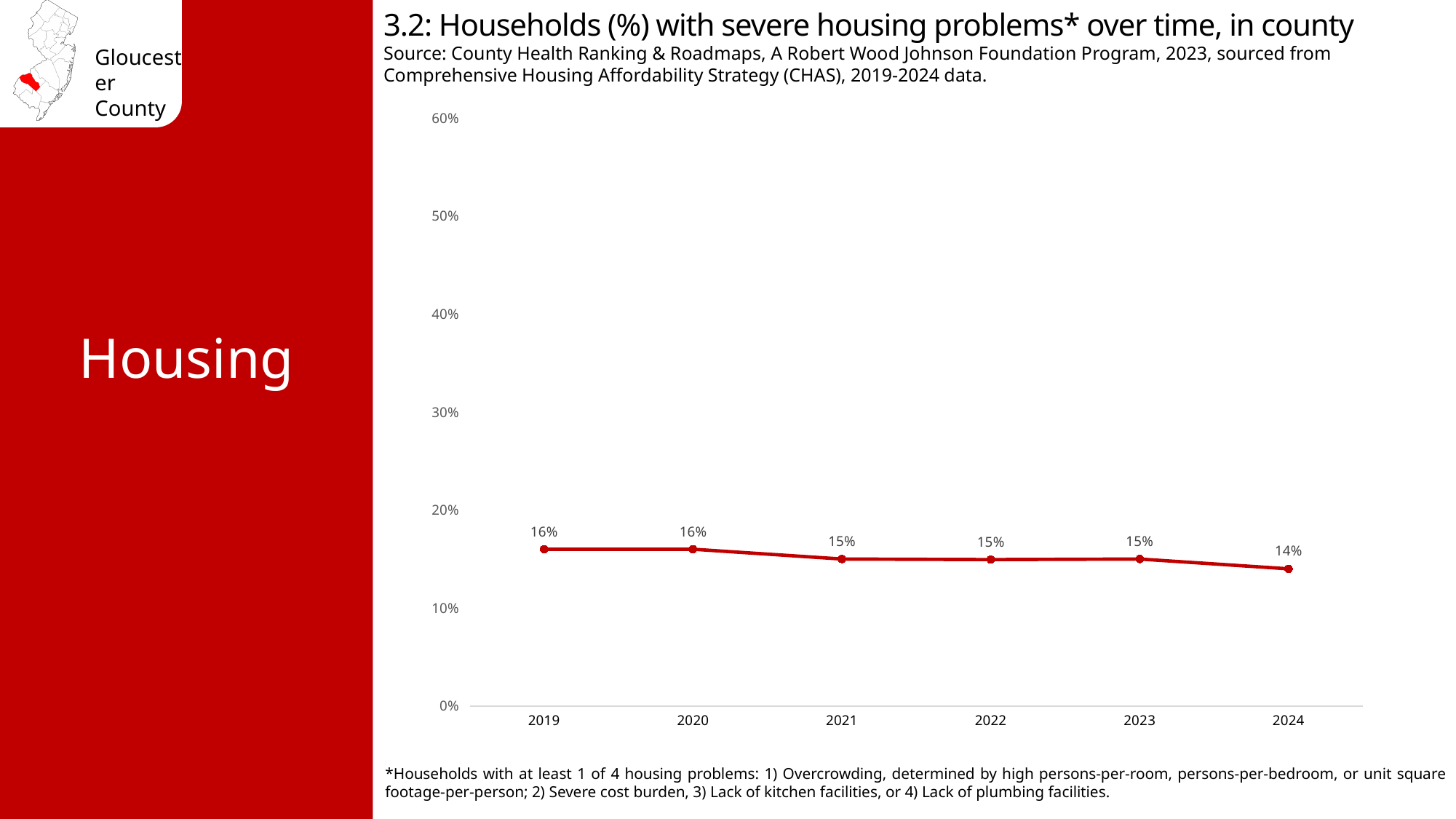
What percentage of households had severe housing problems in 2019? 16% How many years are plotted on the x axis? 6 What kind of chart is shown on the slide? line chart What is the highest value shown on the y axis? 60% What colour is the plotted line? red Do the values rise or fall from 2019 to 2024? fall What is the value shown for 2024? 14% Is the value for 2021 greater or less than 20%? less What is the difference between the 2019 value and the 2024 value? 2% Which year has the lowest percentage of households with severe housing problems? 2024 What is the value shown for 2022? 15% Is the value for 2020 larger or smaller than the value for 2024? larger